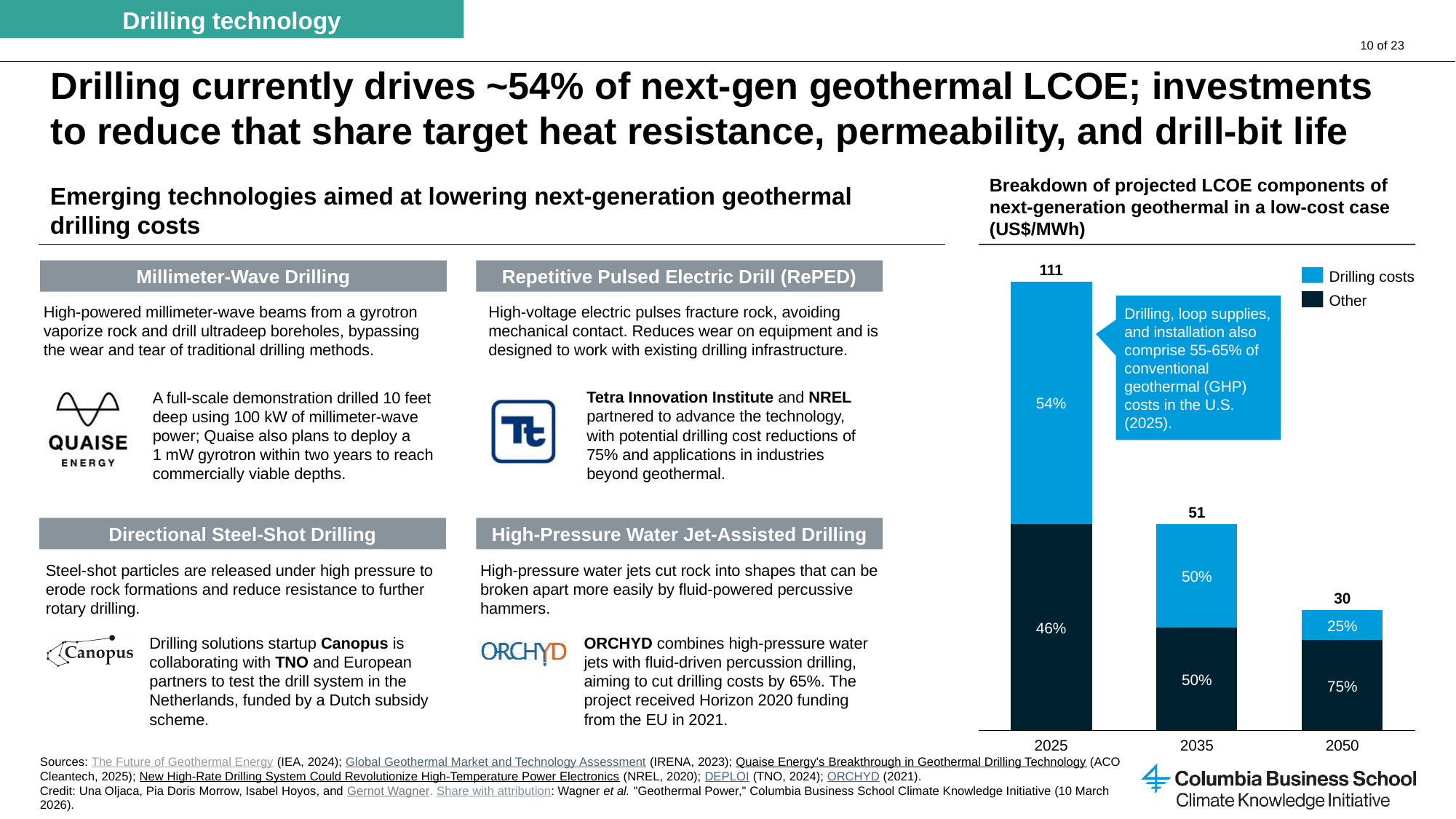
Does the total projected LCOE rise or fall from 2025 to 2050? fall What is the difference between the total LCOE in 2025 and in 2035? 60 Is the total LCOE larger in 2035 or in 2050? 2035 What share of the 2025 bar is drilling costs? 54% How many years are shown on the x axis of the chart? 3 What is the total projected LCOE for 2050 in the chart? 30 What share of the 2035 bar is drilling costs? 50% What share of the 2050 bar is labelled Other? 75% Which year has the lowest total projected LCOE? 2050 What is the total projected LCOE for 2025 in the chart? 111 How many series does the chart legend list? 2 Which year has the highest total projected LCOE? 2025